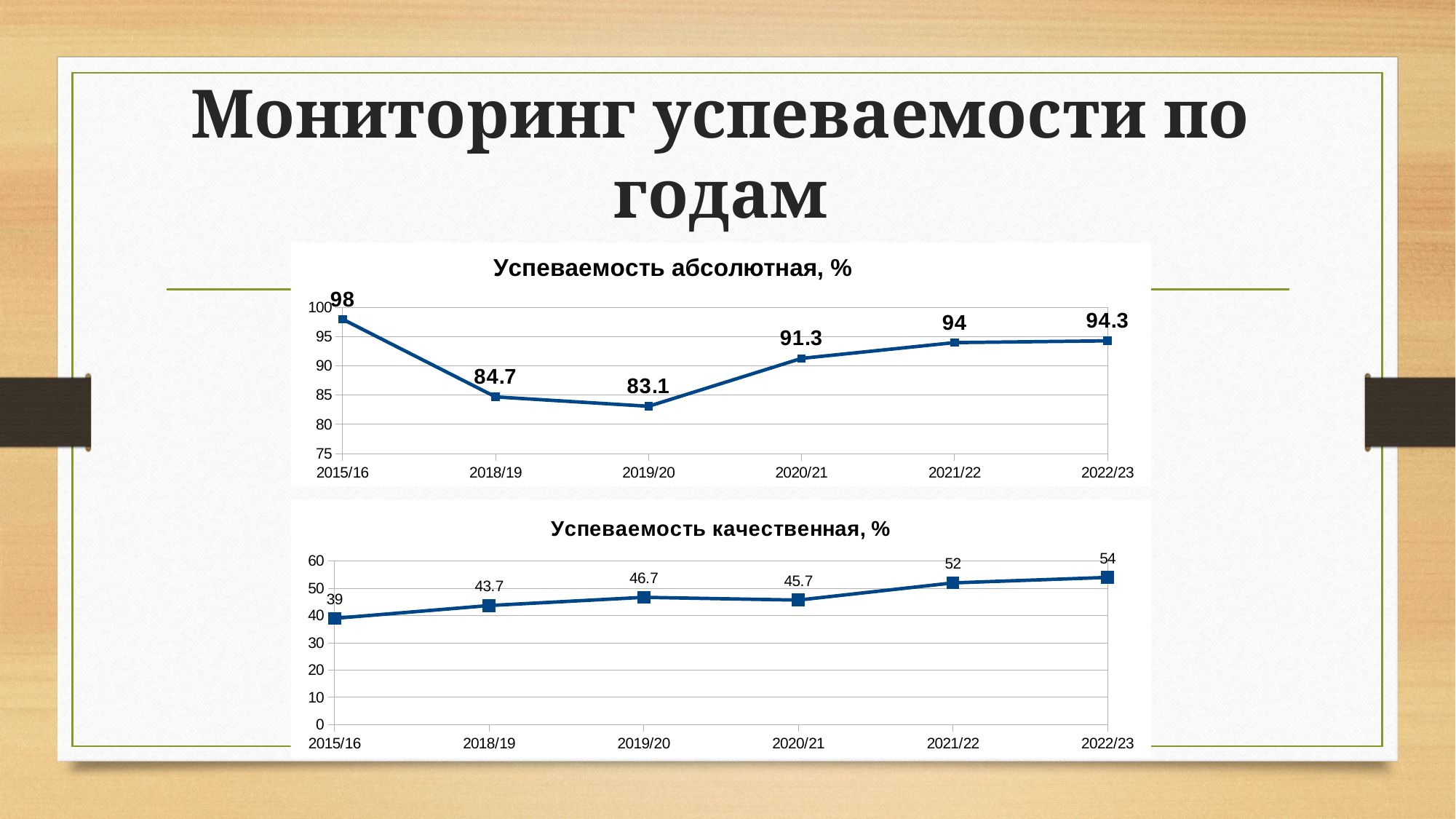
In the chart titled 'Успеваемость качественная, %', what is the value for 2020/21? 45.7 In the chart titled 'Успеваемость абсолютная, %', which year has the highest value? 2015/16 In the chart titled 'Успеваемость качественная, %', which year has the highest value? 2022/23 In the chart titled 'Успеваемость качественная, %', which year has the lowest value? 2015/16 In the chart titled 'Успеваемость абсолютная, %', what is the difference between the values for 2015/16 and 2018/19? 13.3 What kind of chart is the chart titled 'Успеваемость абсолютная, %'? Line chart In the chart titled 'Успеваемость абсолютная, %', which year has the lowest value? 2019/20 In the chart titled 'Успеваемость абсолютная, %', how many data points are plotted? 6 In the chart titled 'Успеваемость абсолютная, %', what is the value for 2019/20? 83.1 In the chart titled 'Успеваемость качественная, %', is the value for 2019/20 larger than the value for 2020/21? Yes In the chart titled 'Успеваемость качественная, %', do the values generally rise or fall from 2015/16 to 2022/23? Rise In the chart titled 'Успеваемость качественная, %', what is the difference between the values for 2022/23 and 2015/16? 15